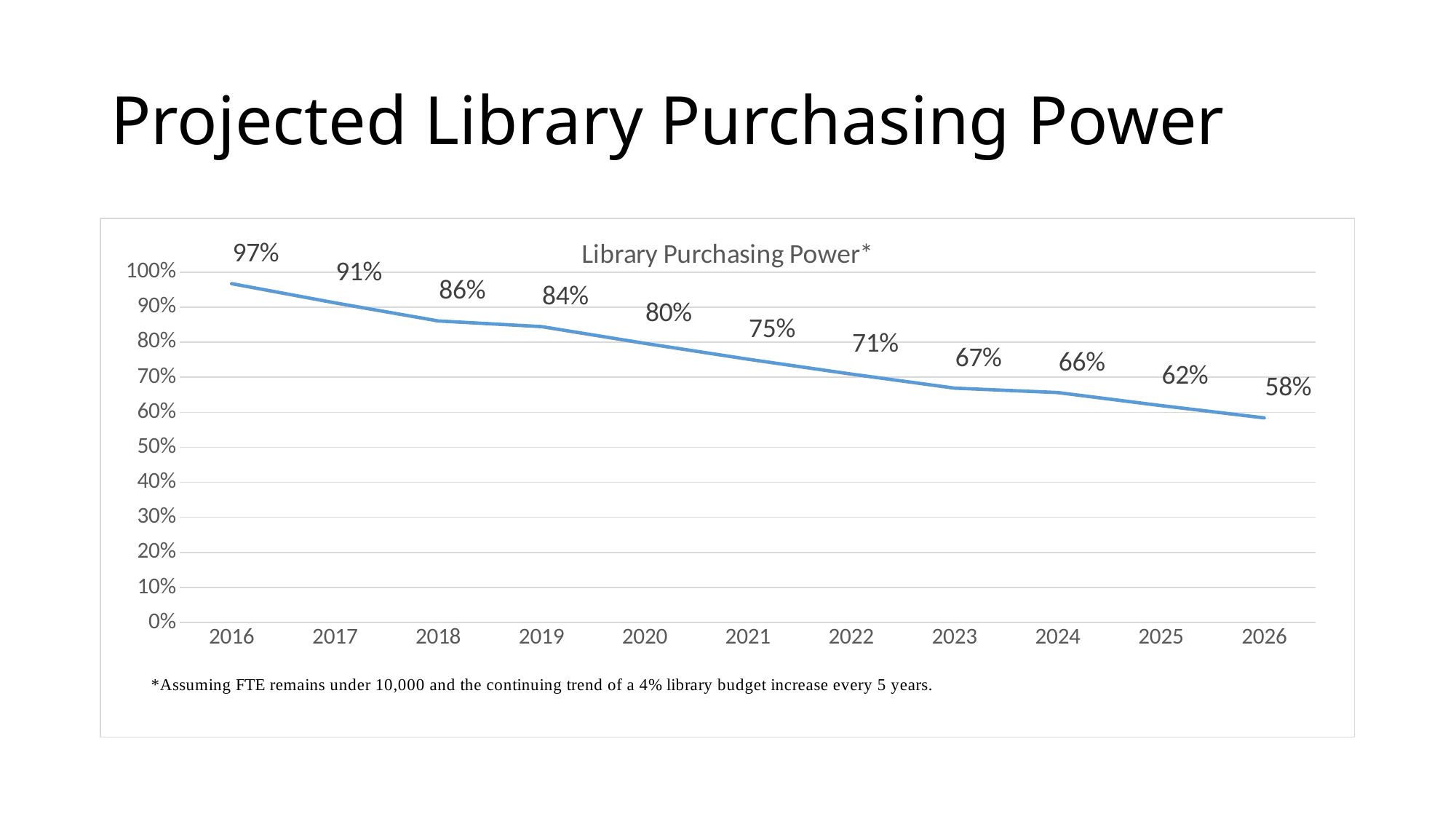
Is the library purchasing power for 2023 greater or less than 70%? less How many years are plotted on the chart? 11 What is the library purchasing power value for 2026? 58% What is the difference in library purchasing power between 2016 and 2026? 39% Which year has the highest library purchasing power? 2016 What is the library purchasing power value for 2016? 97% What kind of chart is shown on the slide? line chart Which year has the lowest library purchasing power? 2026 Which year has a higher library purchasing power, 2018 or 2022? 2018 Does library purchasing power rise or fall from 2016 to 2026? fall What is the difference in library purchasing power between 2019 and 2020? 4% What is the library purchasing power value for 2021? 75%